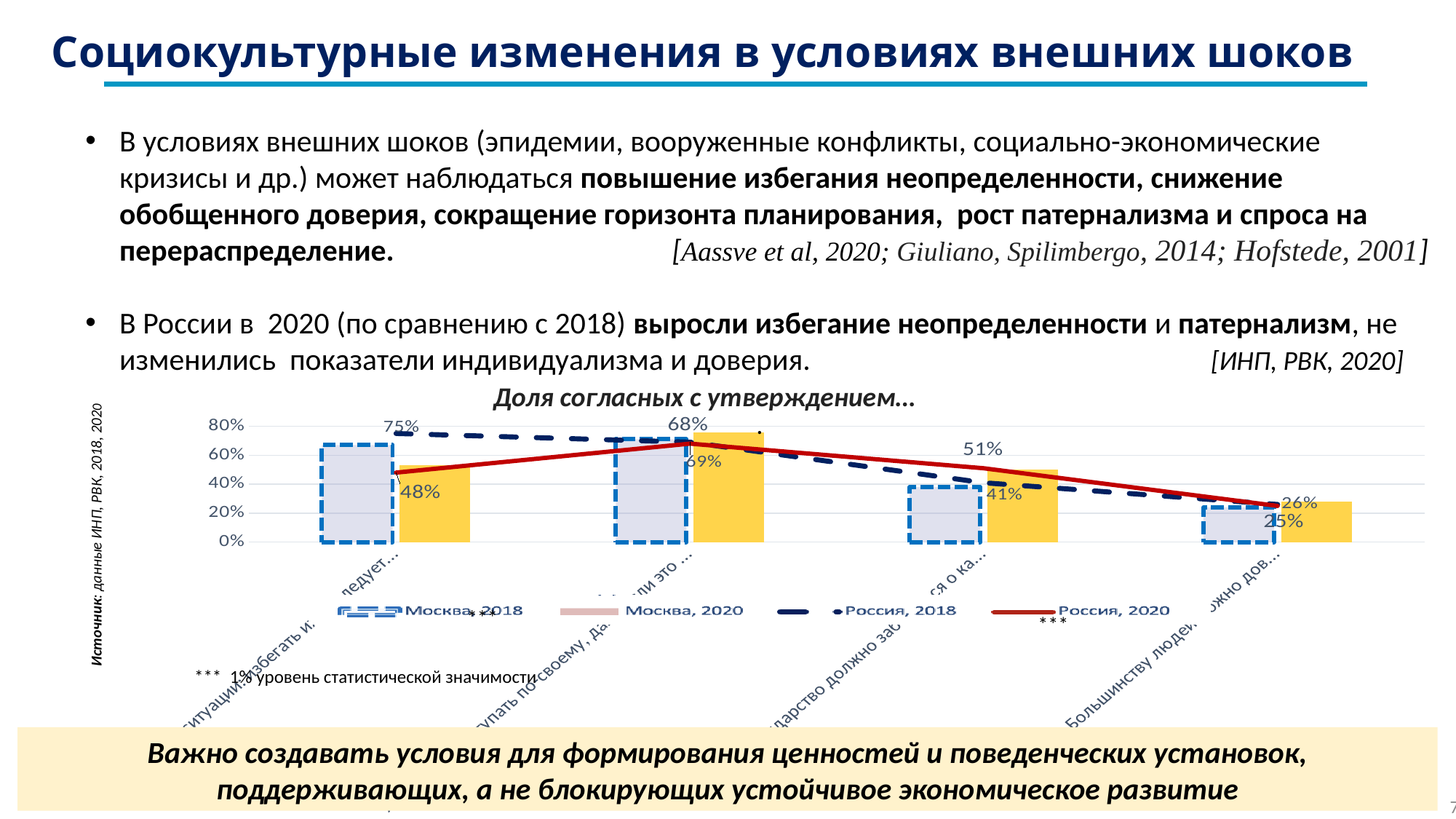
Is the Москва, 2018 bar at the fourth (rightmost) category greater or less than 40%? less What is the value of the Россия, 2018 series at the first (leftmost) category? 75% At the third category from the left, which is larger: Россия, 2018 or Россия, 2020? Россия, 2020 What is the title of the chart on the slide? Доля согласных с утверждением... What is the value of the Россия, 2020 series at the first (leftmost) category? 48% Is the Москва, 2020 bar at the second category from the left greater or less than 60%? greater What kind of chart is shown on the slide? Combined bar and line chart Does the Россия, 2018 line rise or fall from the first category to the last? Fall What is the value of the Россия, 2020 series at the third category from the left? 51% How many series does the chart legend list? 4 How many category groups are plotted along the x axis of the chart? 4